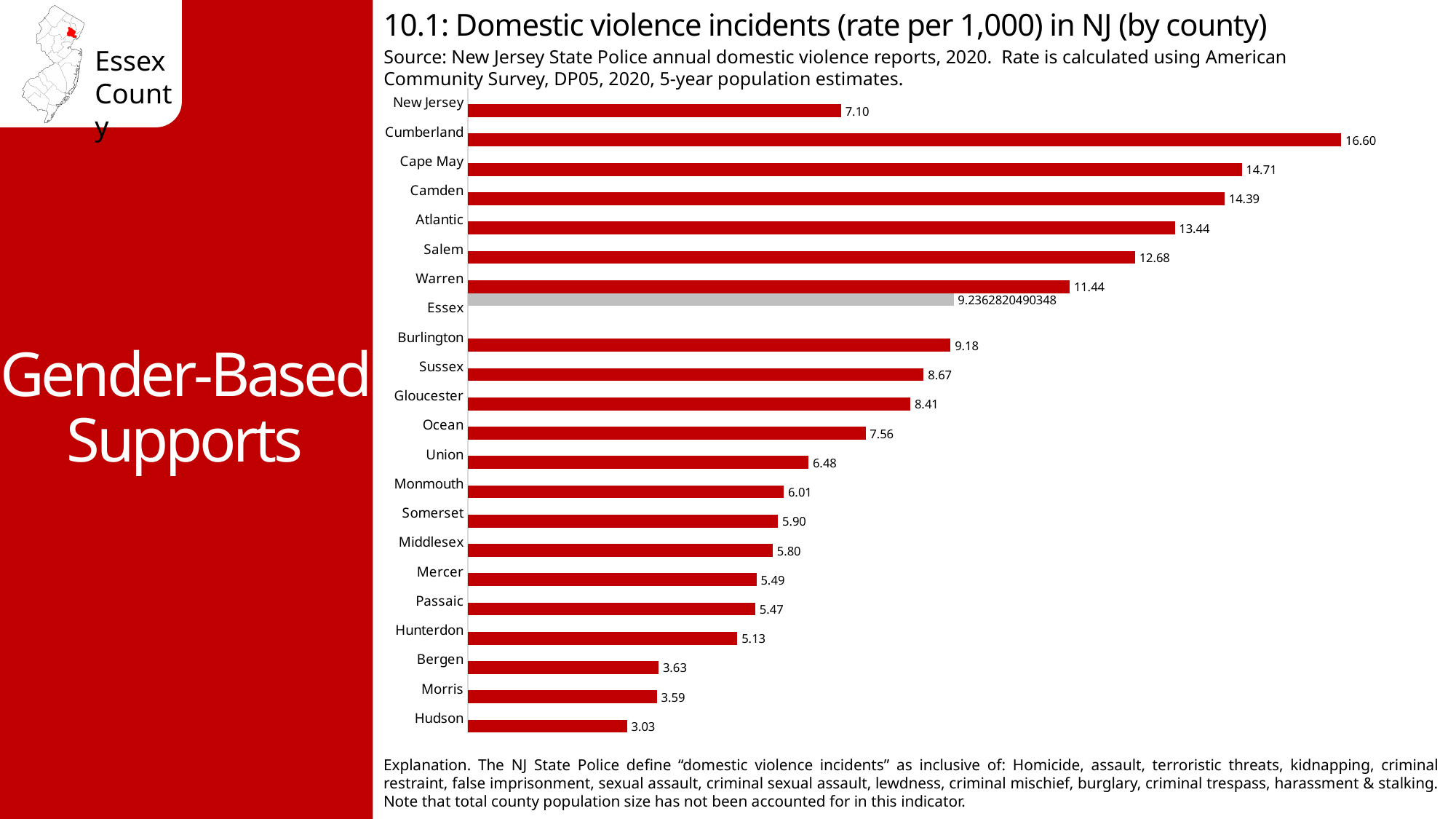
How many bars are plotted in the chart? 22 What is the difference between the rates for Cumberland and Hudson? 13.57 What is the difference between the rates for Salem and Warren? 1.24 What is the domestic violence incident rate for Cumberland? 16.60 Which has a higher rate, Cape May or Camden? Cape May What type of chart is shown on the slide? Bar chart What is the rate shown for New Jersey overall? 7.10 Which county has the highest domestic violence incident rate? Cumberland Which county has the lowest domestic violence incident rate? Hudson What is the domestic violence incident rate for Hudson? 3.03 Which bar is coloured grey instead of red? Essex What value is shown for Essex? 9.2362820490348